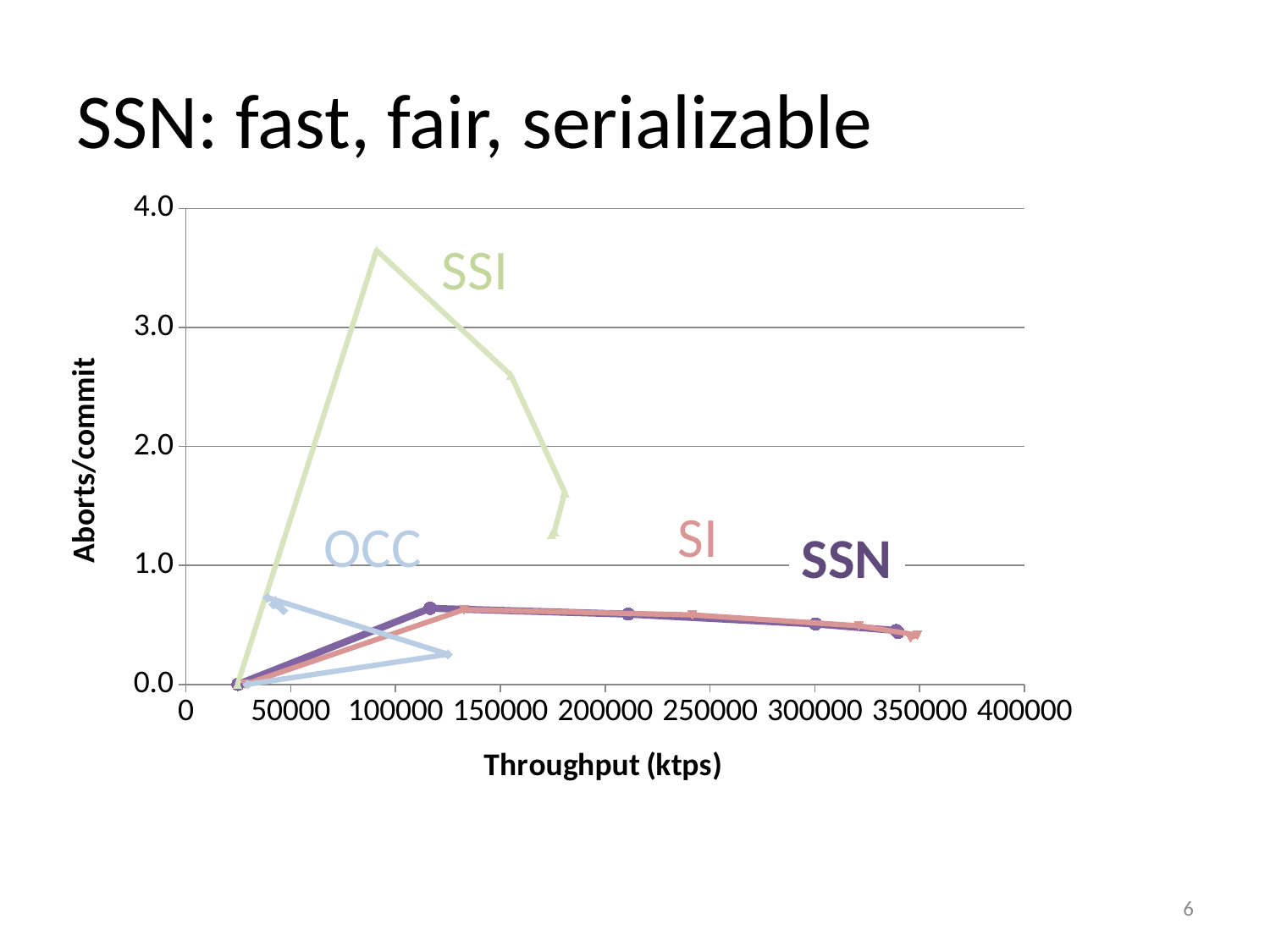
Is the highest throughput reached by OCC greater or less than 150000? less Is the peak aborts/commit value for SSI greater or less than 3.0? greater How many series are labelled on the chart? 4 What is the title of the slide containing the chart? SSN: fast, fair, serializable What kind of chart is shown on the slide? line chart Which series reaches a higher peak aborts/commit value, SSI or OCC? SSI What is the label of the x axis? Throughput (ktps) Which series reaches a higher throughput, OCC or SI? SI What is the label of the y axis? Aborts/commit Is the peak aborts/commit value for SSN greater or less than 1.0? less Which series reaches the highest aborts/commit value on the chart? SSI